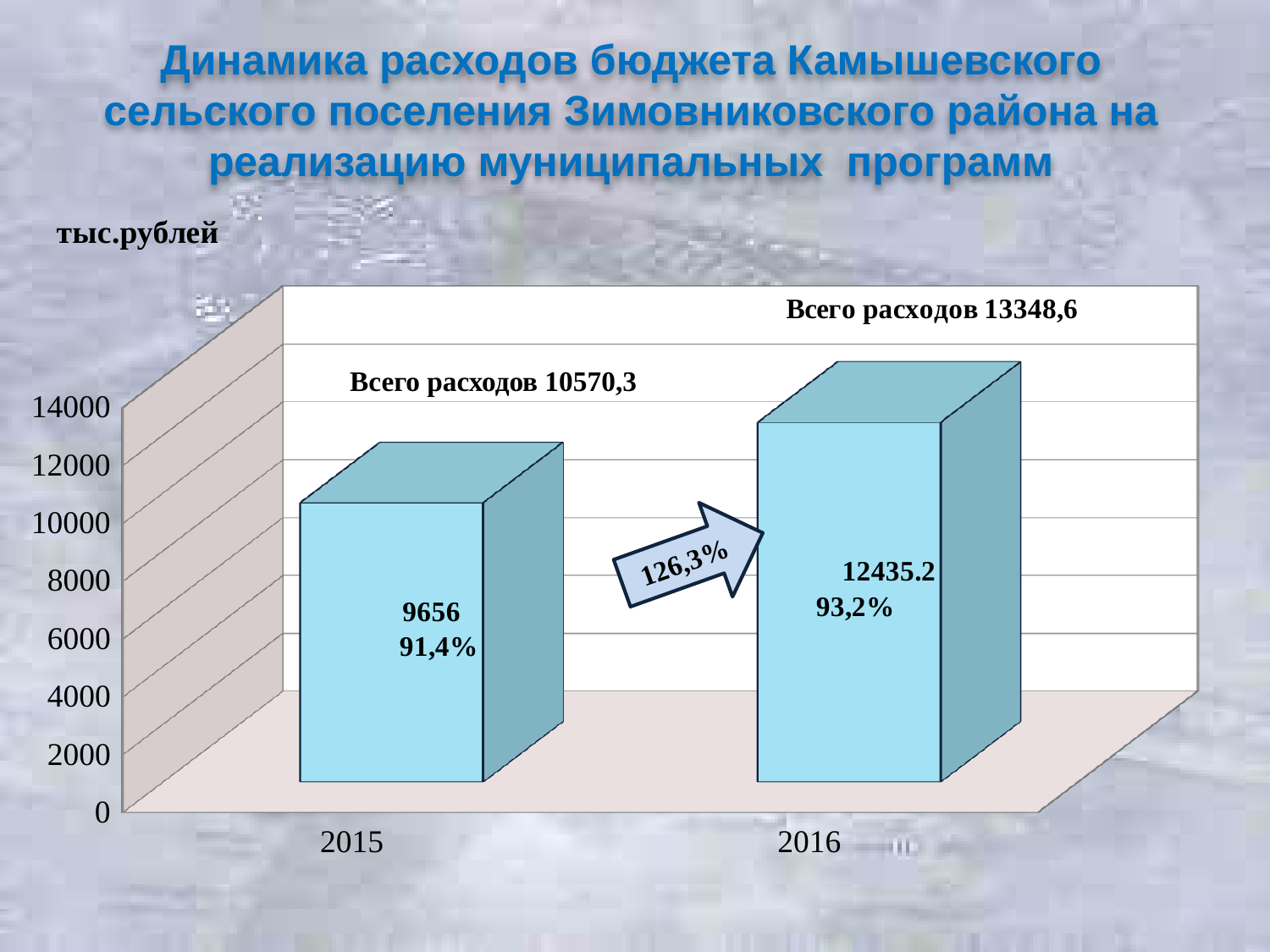
What is the total expenditure (Всего расходов) shown for 2015? 10570,3 What is the value of the bar for 2015? 9656 Which year has the higher bar value? 2016 What percentage is printed on the 2016 bar? 93,2% Which year has the lower bar value? 2015 What is the difference between the 2016 bar value and the 2015 bar value? 2779.2 What is the value of the bar for 2016? 12435.2 What type of chart is shown on the slide? bar chart What is the total expenditure (Всего расходов) shown for 2016? 13348,6 Is the value for 2015 greater or less than 10000? less What percentage is printed on the 2015 bar? 91,4% What percentage is written on the arrow between the two bars? 126,3%